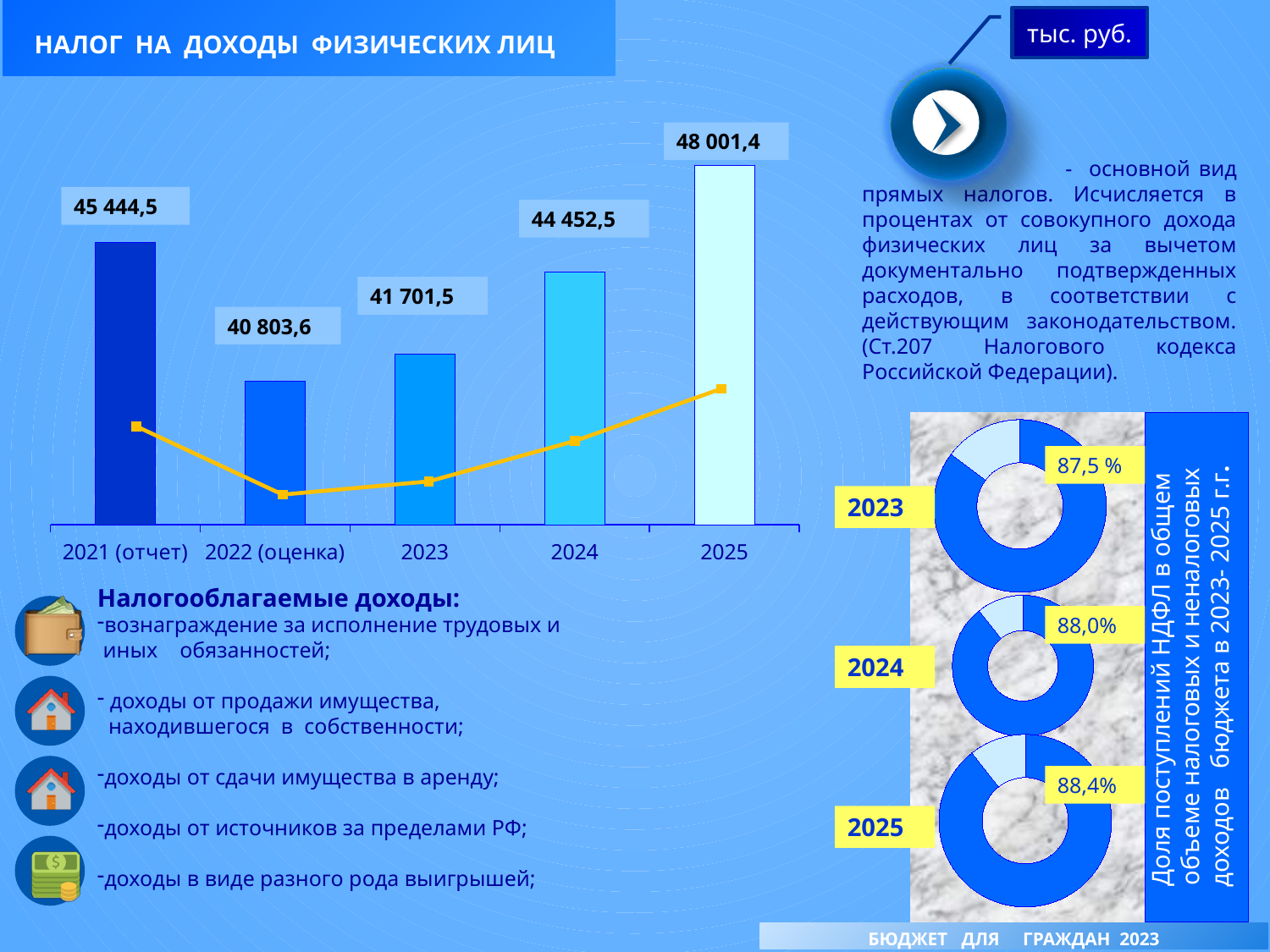
In the bar chart on the left, do the values rise or fall from 2022 (оценка) to 2025? rise In the bar chart on the left, what is the value for 2025? 48 001,4 In the bar chart on the left, what is the difference between the values for 2024 and 2023? 2 751,0 How many years (categories) are shown in the bar chart on the left? 5 In the donut charts on the right, which year has the highest share? 2025 In the bar chart on the left, which is larger: the value for 2023 or the value for 2022 (оценка)? 2023 In the bar chart on the left, what is the value for 2021 (отчет)? 45 444,5 In the bar chart on the left, which year has the lowest value? 2022 (оценка) In the bar chart on the left, which year has the highest value? 2025 In the donut charts on the right, what share is shown for 2024? 88,0% In the bar chart on the left, what is the difference between the values for 2025 and 2021 (отчет)? 2 556,9 In the bar chart on the left, what is the value for 2022 (оценка)? 40 803,6